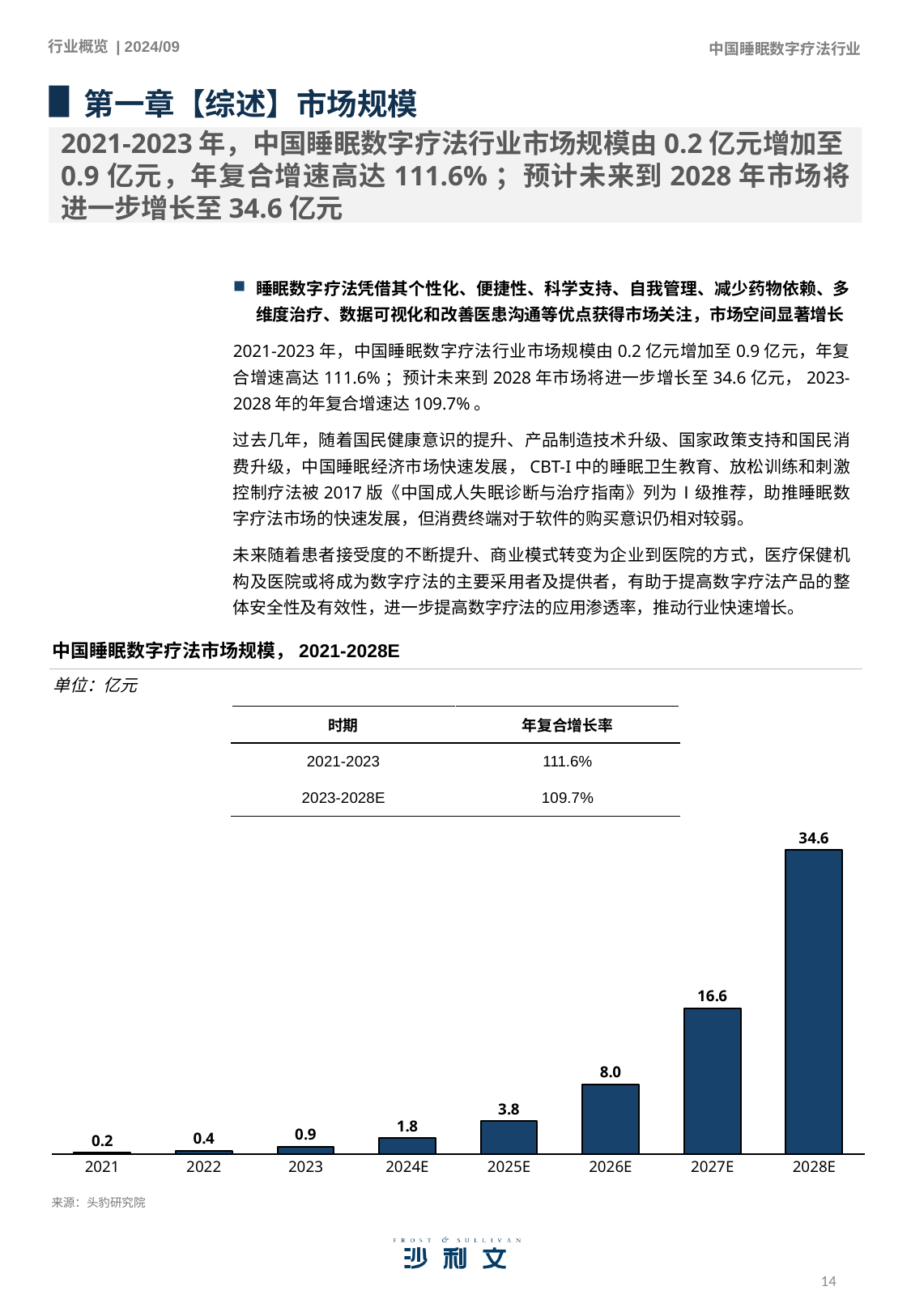
What unit is stated for the chart values? 亿元 What is the value for 2026E in the chart? 8.0 Which year has the highest value in the chart? 2028E Do the values rise or fall from 2021 to 2028E? Rise What is the value for 2028E in the chart? 34.6 How many years are shown on the x axis of the chart? 8 What is the difference between the values for 2025E and 2024E? 2.0 What kind of chart is shown on the slide? Bar chart Which is larger, the value for 2024E or the value for 2022? 2024E What is the difference between the values for 2028E and 2027E? 18.0 What is the value for 2023 in the chart? 0.9 Which year has the lowest value in the chart? 2021